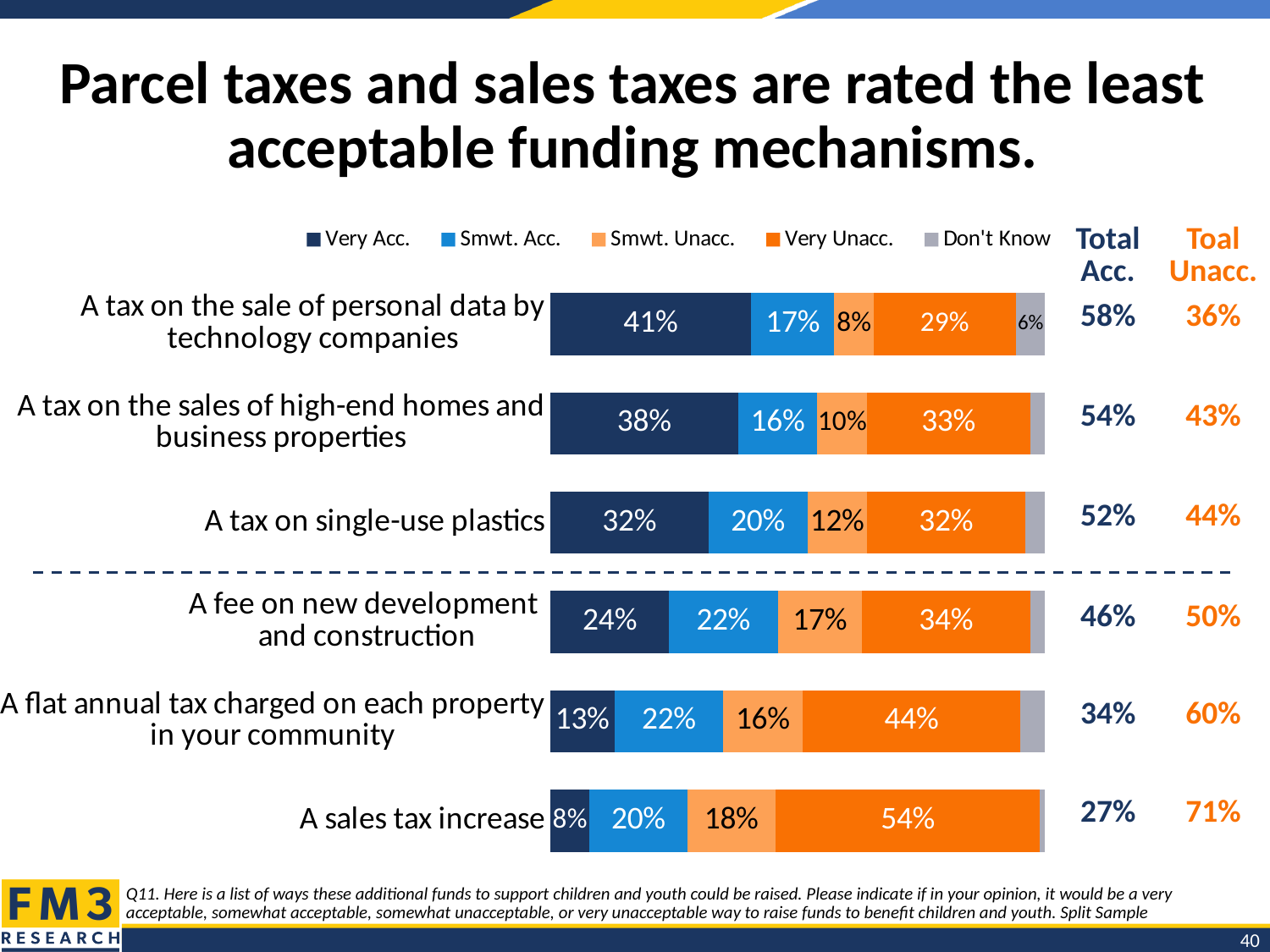
What kind of chart is shown on the slide? Stacked bar chart What is the Very Unacc. value for 'A flat annual tax charged on each property in your community'? 44% What is the Total Acc. value shown for 'A fee on new development and construction'? 46% What is the first entry in the chart's legend? Very Acc. Which has the larger Smwt. Acc. value: 'A tax on single-use plastics' or 'A tax on the sale of personal data by technology companies'? A tax on single-use plastics What is the Don't Know value for 'A tax on the sale of personal data by technology companies'? 6% What percentage rated 'A sales tax increase' as Very Acc.? 8% Which funding mechanism has the highest Very Unacc. value? A sales tax increase Which funding mechanism has the lowest Very Acc. value? A sales tax increase How many funding mechanisms are shown in the chart? 6 How many series does the legend list? 5 How much higher is the Very Unacc. value for 'A sales tax increase' than for 'A flat annual tax charged on each property in your community'? 10 percentage points